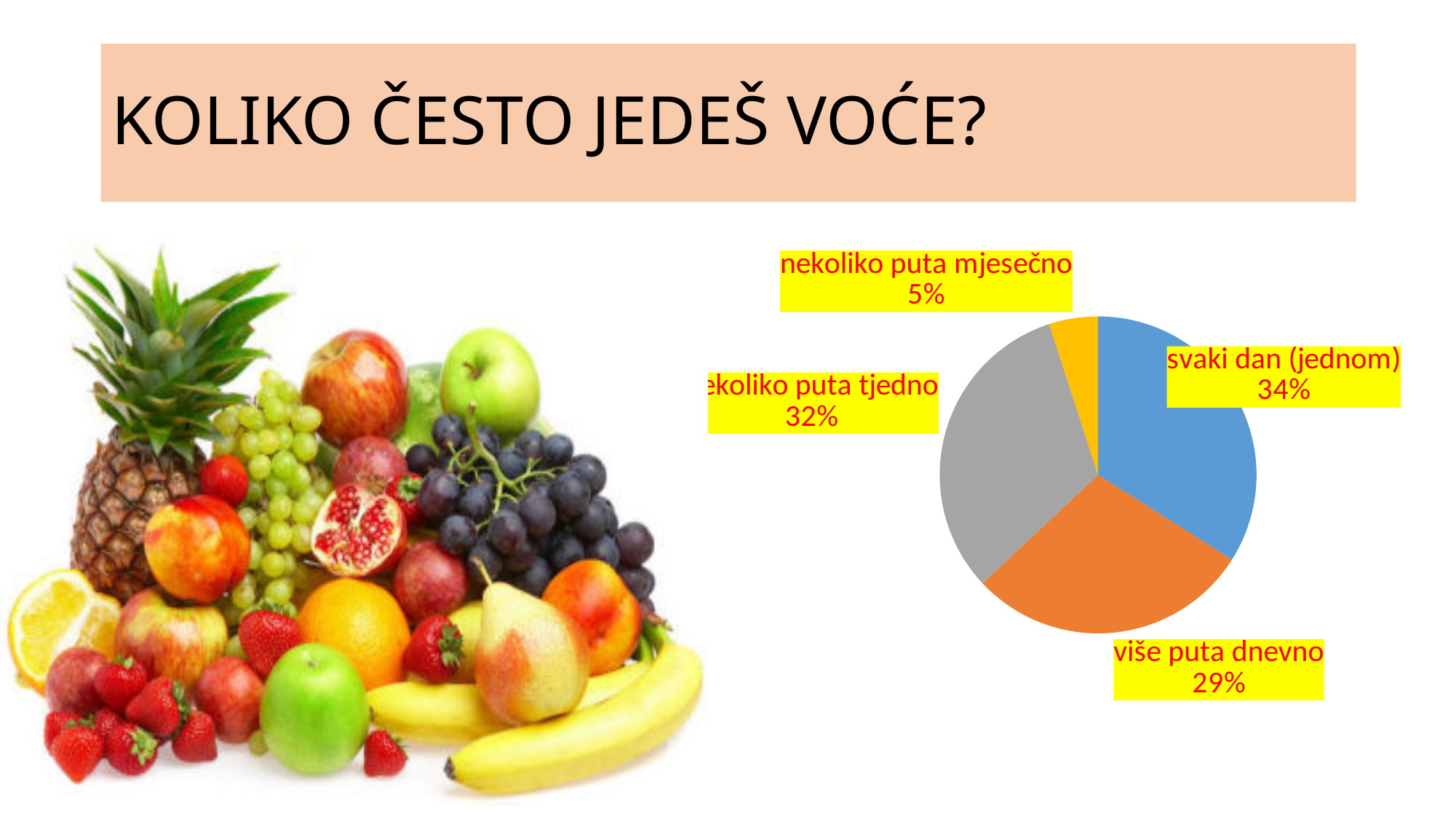
What percentage is shown for "nekoliko puta mjesečno"? 5% Which category has the smallest share of the pie chart? nekoliko puta mjesečno What share of the pie chart is labelled "svaki dan (jednom)"? 34% What percentage is shown for "nekoliko puta tjedno"? 32% Which is larger, the share for "nekoliko puta tjedno" or the share for "više puta dnevno"? nekoliko puta tjedno How many slices does the pie chart have? 4 What percentage is shown for "više puta dnevno"? 29% What is the title of the slide containing the chart? KOLIKO ČESTO JEDEŠ VOĆE? What is the difference in percentage points between "svaki dan (jednom)" and "više puta dnevno"? 5 Which category has the largest share of the pie chart? svaki dan (jednom) What type of chart is shown on the slide? pie chart What is the difference in percentage points between "nekoliko puta tjedno" and "nekoliko puta mjesečno"? 27